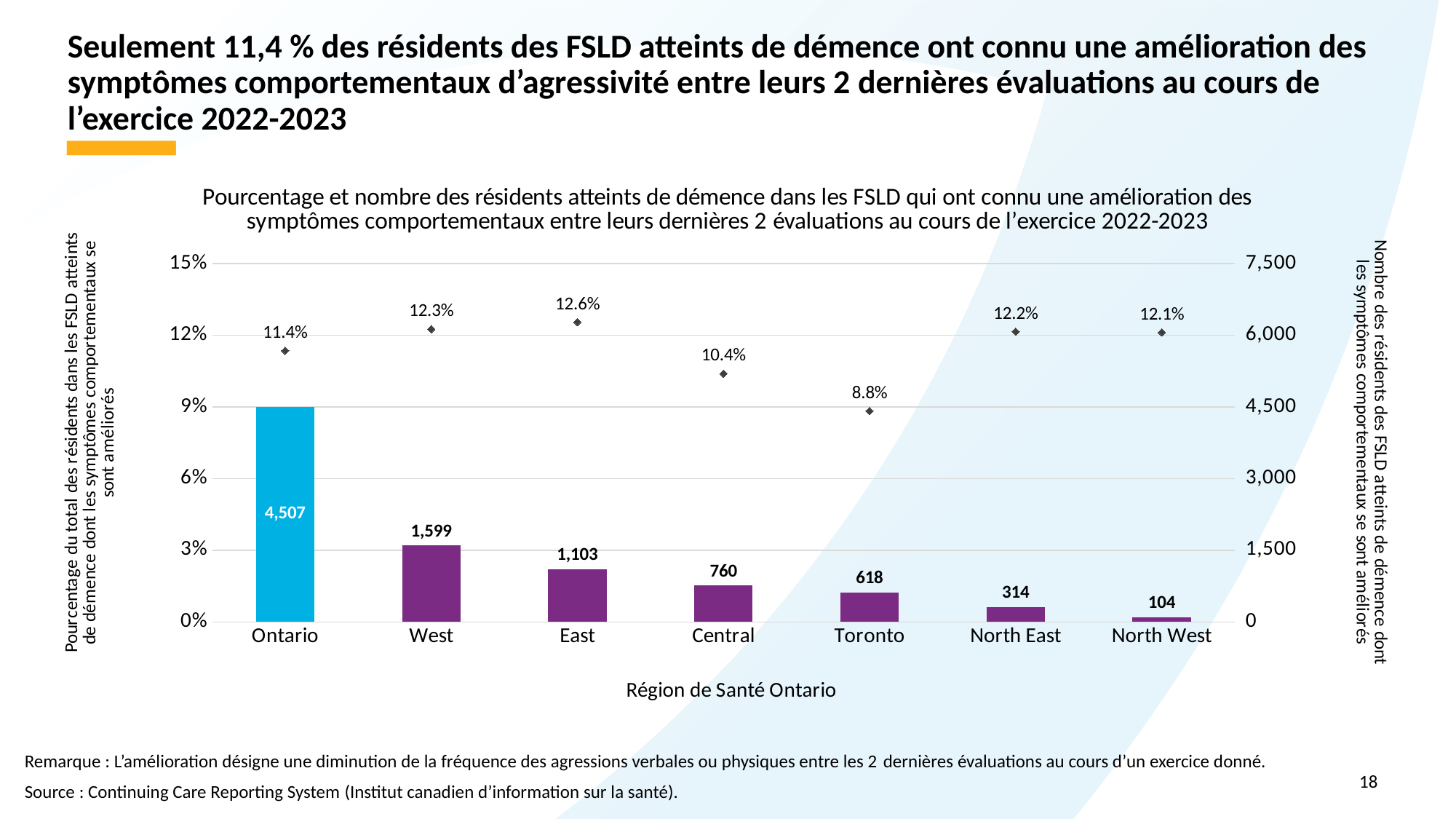
Which region has the highest percentage value? East What is the number of residents shown for Toronto? 618 What is the difference between the percentage for East and the percentage for Toronto? 3.8% What is the difference between the number of residents for Ontario and for West? 2,908 What kind of chart is shown on the slide? combination bar and line chart (bars with point markers on a secondary axis) What is the title of the x axis? Région de Santé Ontario What is the number of residents shown for the West region? 1,599 What percentage is shown for the Central region? 10.4% Which region has the smallest number of residents (shortest bar)? North West Which region has the lowest percentage value? Toronto How many regions are shown on the x axis? 7 Which has the larger percentage value, North East or North West? North East